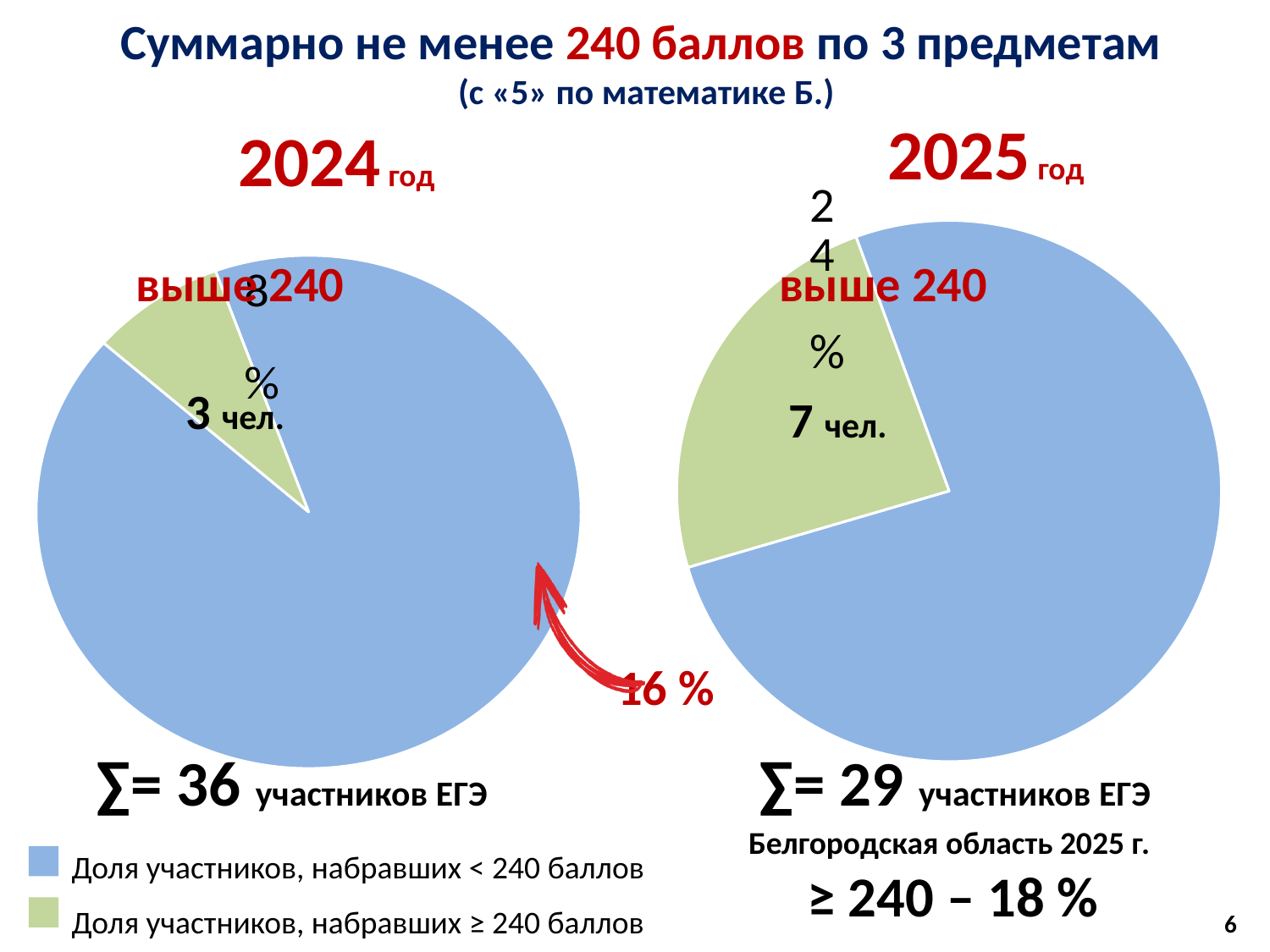
What kind of chart is used to show the 2024 and 2025 data on this slide? pie chart What colour represents the share of participants who scored 240 or more points? green How many ЕГЭ participants in total are shown for the 2024 pie chart? 36 How many entries does the legend list? 2 How many ЕГЭ participants in total are shown for the 2025 pie chart? 29 What share of participants scoring 240 or more is given for Белгородская область in 2025? 18 % By how many percentage points did the share of participants scoring 240 or more increase from 2024 to 2025? 16 % In the 2025 pie chart, how many people scored 240 or more points? 7 чел. In the 2025 pie chart, what percentage of participants scored 240 or more points? 24% How many slices does each pie chart have? 2 In the 2024 pie chart, how many people scored 240 or more points? 3 чел. Which year's pie chart has the larger share of participants scoring 240 or more points, 2024 or 2025? 2025